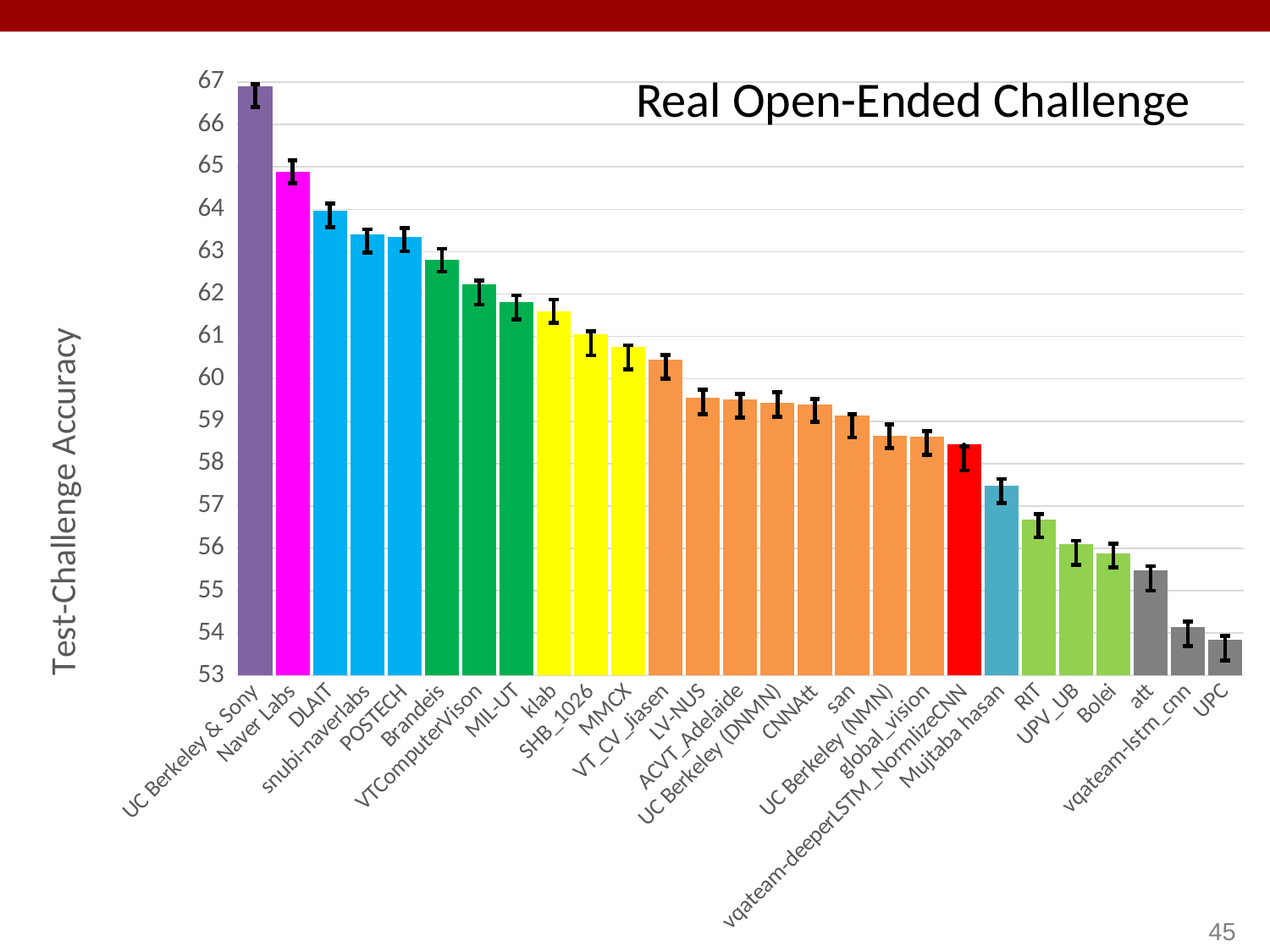
How many teams (bars) are shown in the chart? 27 Is the Test-Challenge Accuracy for Mujtaba hasan greater or less than 58? less What is the label on the vertical axis of the chart? Test-Challenge Accuracy Which has a higher Test-Challenge Accuracy, DLAIT or MIL-UT? DLAIT What kind of chart is shown on the slide? bar chart Which team has the highest Test-Challenge Accuracy? UC Berkeley & sony Is the Test-Challenge Accuracy for Naver Labs greater or less than 64? greater Do the bar values rise or fall from left to right along the x axis? fall What is the title of the chart? Real Open-Ended Challenge Which team has the lowest Test-Challenge Accuracy? UPC Which has a higher Test-Challenge Accuracy, RIT or att? RIT Is the Test-Challenge Accuracy for Brandeis greater or less than 62? greater